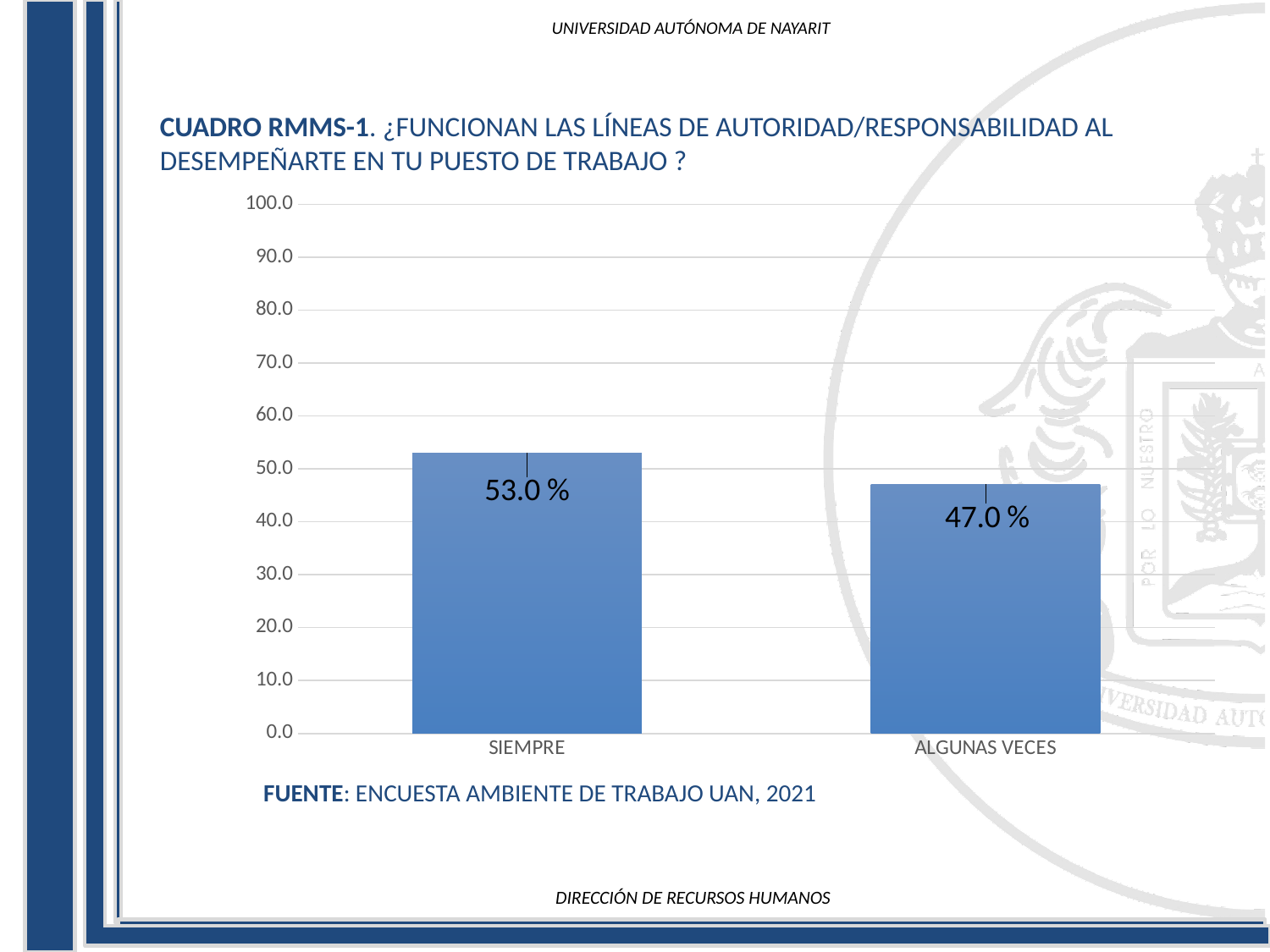
Is the value for ALGUNAS VECES greater or less than 50.0? less What kind of chart is shown on the slide? bar chart Which category has the lowest value? ALGUNAS VECES Which is larger, the value for SIEMPRE or the value for ALGUNAS VECES? SIEMPRE How many categories are shown on the x axis? 2 What is the difference between the values for SIEMPRE and ALGUNAS VECES? 6.0 % What is the value for SIEMPRE? 53.0 % Is the value for SIEMPRE greater or less than 50.0? greater What is the maximum value shown on the y axis? 100.0 Which category has the highest value? SIEMPRE What is the total of the two bar values? 100.0 % What is the value for ALGUNAS VECES? 47.0 %